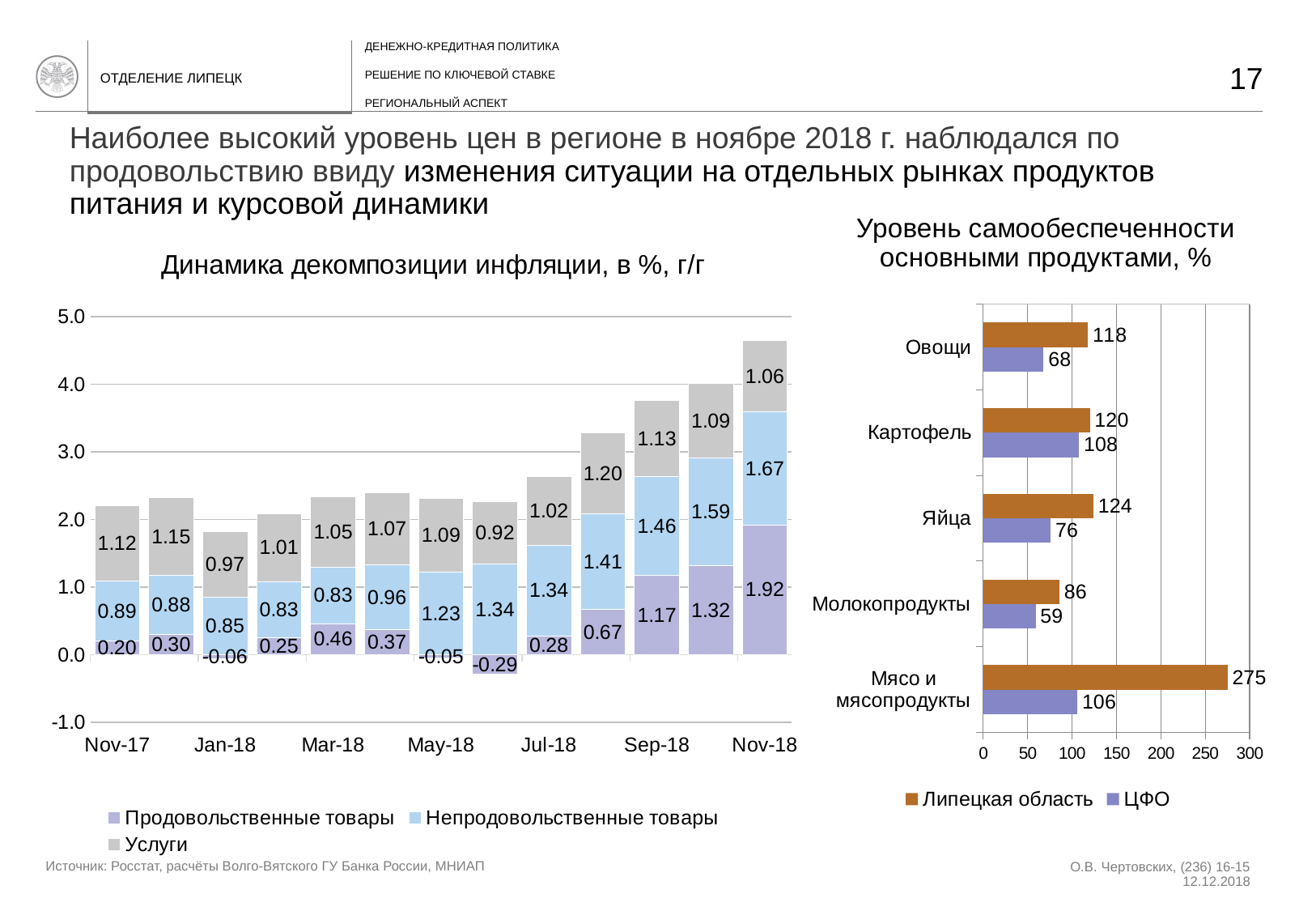
In the chart 'Уровень самообеспеченности основными продуктами, %', how many product categories are shown? 5 In the chart 'Уровень самообеспеченности основными продуктами, %', how many series does the legend list? 2 In the chart 'Уровень самообеспеченности основными продуктами, %', what is the difference between the Липецкая область and ЦФО values for Яйца? 48 In the chart 'Динамика декомпозиции инфляции, в %, г/г', which is larger in Nov-18: Продовольственные товары or Непродовольственные товары? Продовольственные товары In the chart 'Уровень самообеспеченности основными продуктами, %', which product has the highest value for Липецкая область? Мясо и мясопродукты In the chart 'Динамика декомпозиции инфляции, в %, г/г', what is the value for Продовольственные товары in Jan-18? -0.06 In the chart 'Уровень самообеспеченности основными продуктами, %', which product has the lowest value for ЦФО? Молокопродукты What kind of chart is 'Динамика декомпозиции инфляции, в %, г/г'? Stacked bar chart In the chart 'Уровень самообеспеченности основными продуктами, %', what is the value for ЦФО for Картофель? 108 In the chart 'Уровень самообеспеченности основными продуктами, %', what is the value for Липецкая область for Мясо и мясопродукты? 275 In the chart 'Динамика декомпозиции инфляции, в %, г/г', what is the total of the stacked bar for Nov-18? 4.65 In the chart 'Динамика декомпозиции инфляции, в %, г/г', what is the value for Услуги in Nov-18? 1.06